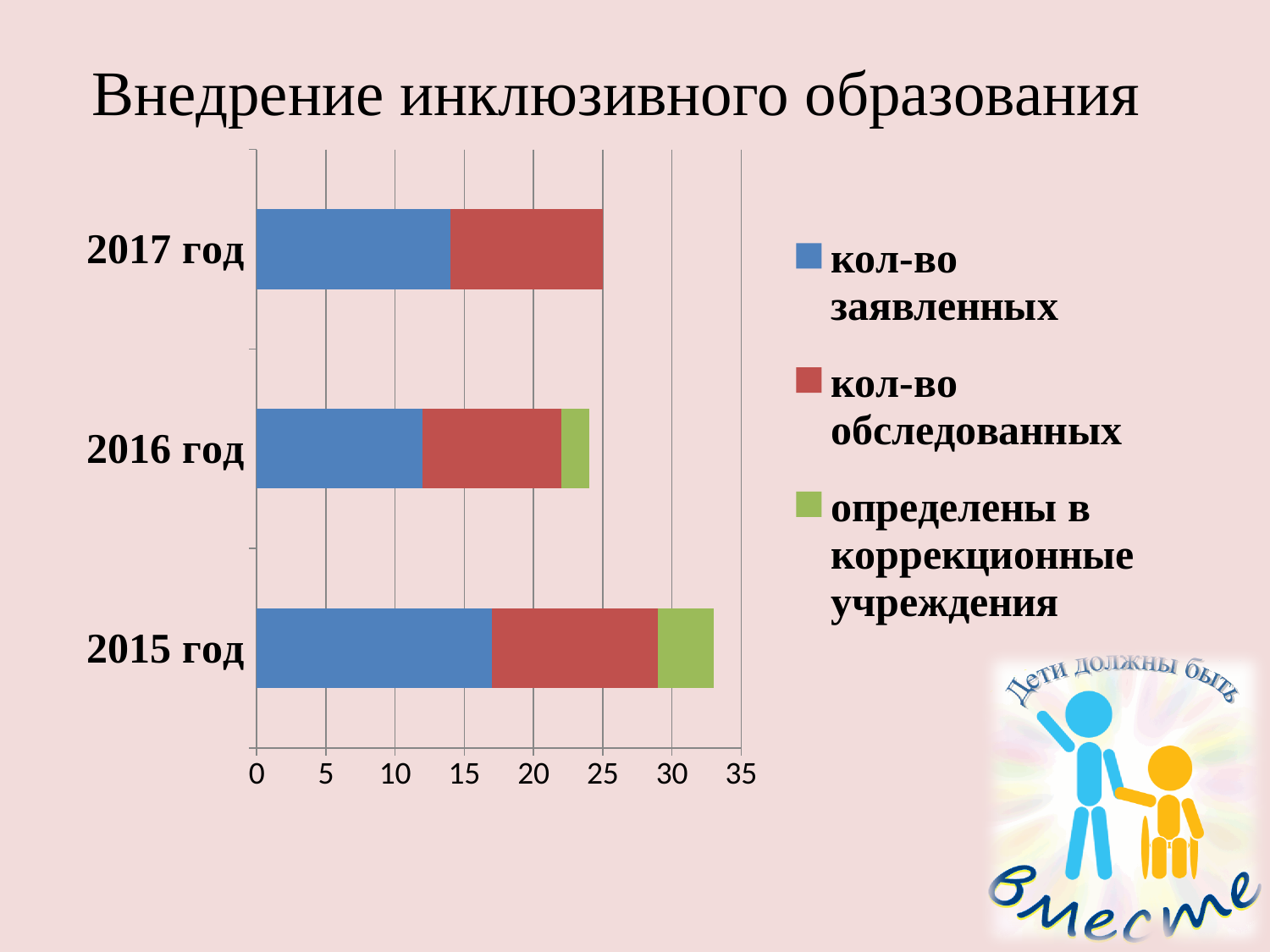
Is the 'кол-во заявленных' value for 2017 год greater or less than 10? greater How many series does the legend list? 3 What kind of chart is shown on the slide? bar chart Is the total stacked bar for 2016 год greater or less than 30? less Is the 'кол-во заявленных' value for 2015 год greater or less than 15? greater Which year has the largest 'кол-во заявленных' (blue) segment? 2015 год Which year has the longest total stacked bar? 2015 год Which year has no 'определены в коррекционные учреждения' (green) segment? 2017 год How many year categories are shown on the chart? 3 What is the title of the chart? Внедрение инклюзивного образования Which colour represents 'кол-во обследованных' in the legend? red